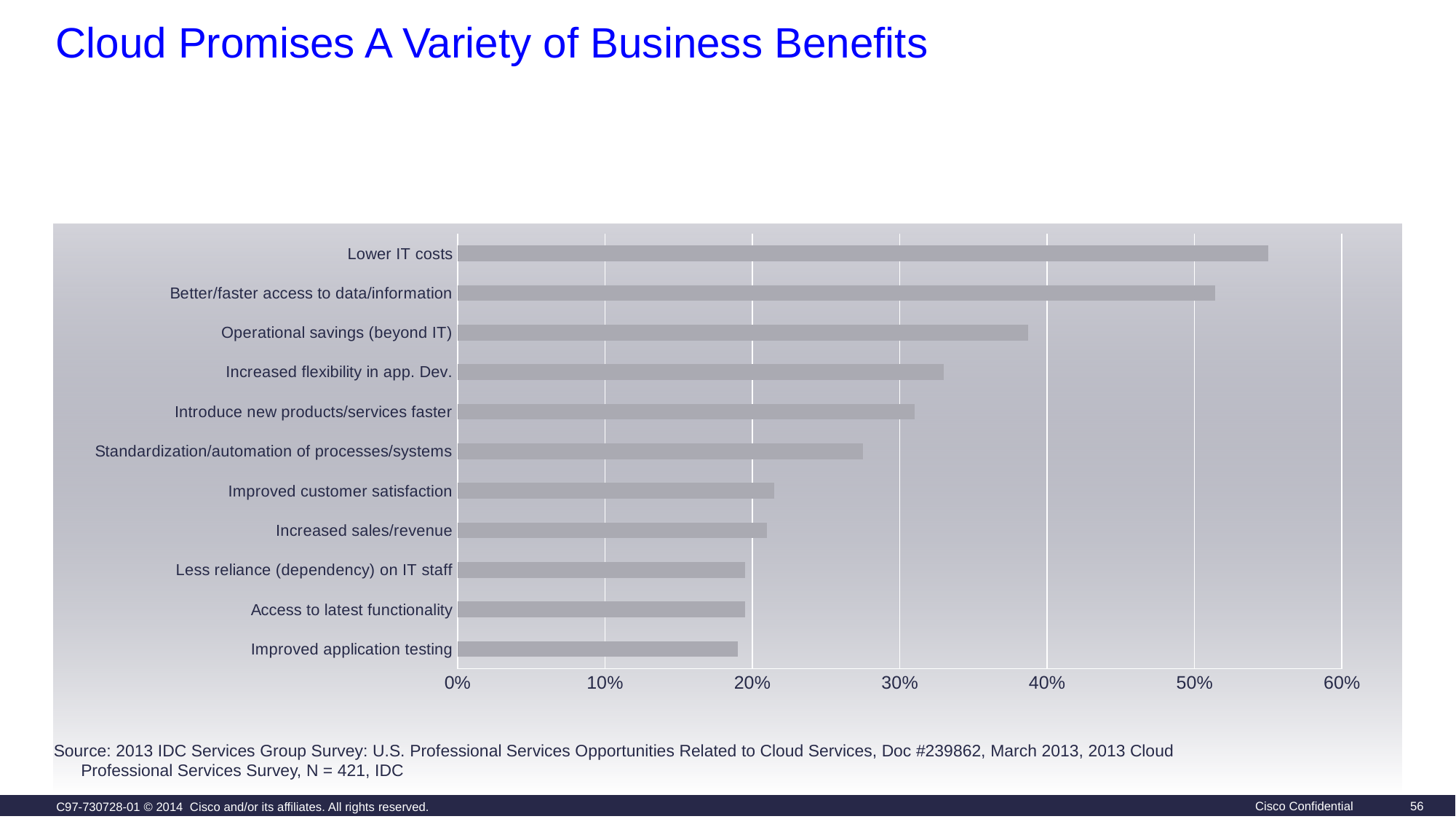
Is the value for Standardization/automation of processes/systems greater or less than 30%? less Do the bar values increase or decrease going from the top category to the bottom category? decrease Which is larger: the value for Better/faster access to data/information or the value for Operational savings (beyond IT)? Better/faster access to data/information Which business benefit has the highest value in the chart? Lower IT costs Which is larger: the value for Introduce new products/services faster or the value for Improved customer satisfaction? Introduce new products/services faster Is the value for Increased flexibility in app. Dev. greater or less than 30%? greater How many categories (business benefits) are plotted in the chart? 11 Is the value for Lower IT costs greater or less than 50%? greater What is the title of the slide containing the chart? Cloud Promises A Variety of Business Benefits What kind of chart is shown on the slide? bar chart